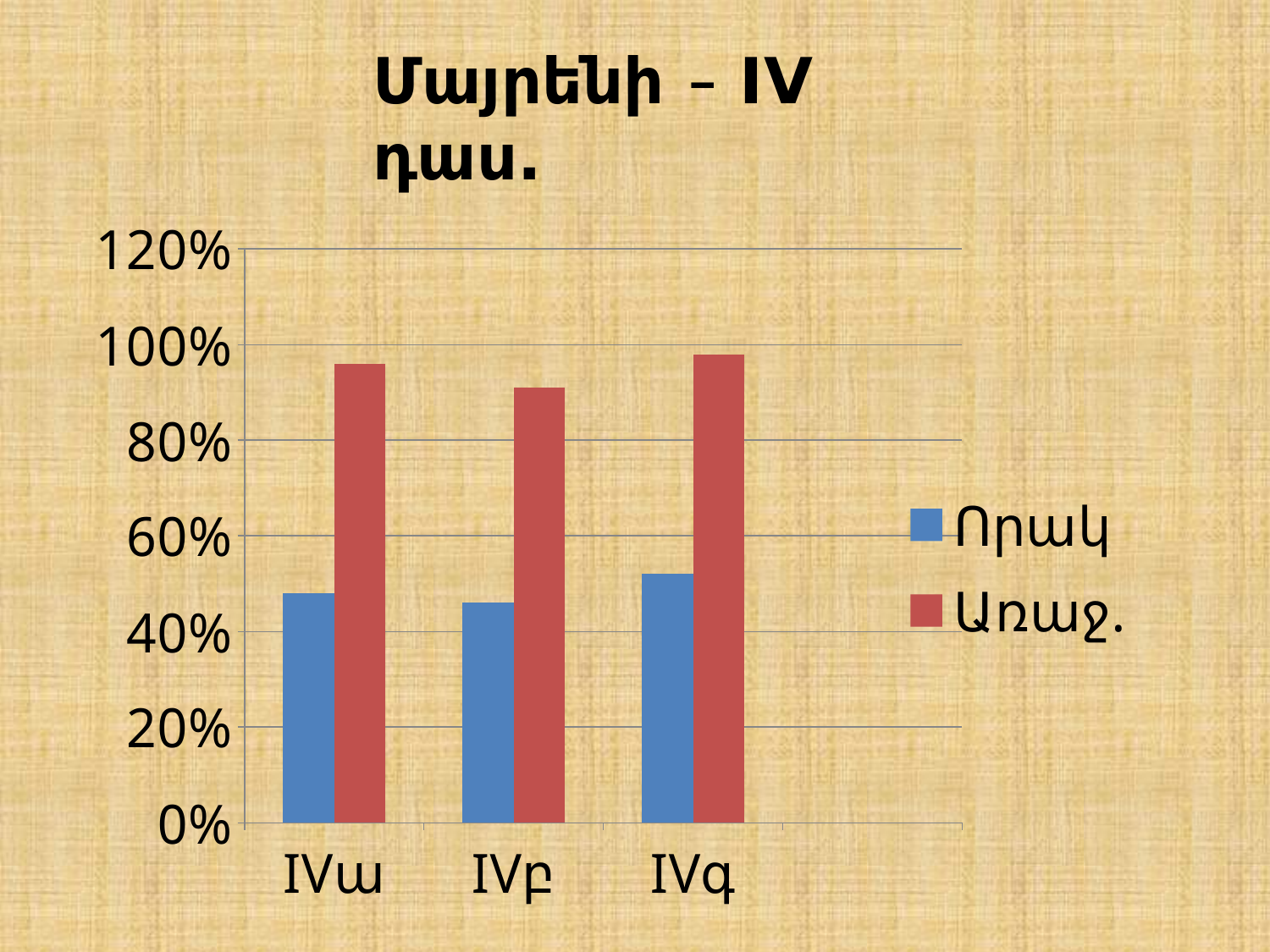
Which category has the lowest value for Առաջ.? IVբ What kind of chart is shown on the slide? bar chart Which category has the highest value for Որակ? IVգ Is the value of Առաջ. for IVբ greater or less than 80%? greater What is the title of the chart? Մայրենի - IV դաս. How many series does the legend list? 2 Which series is shown in red in the chart? Առաջ. How many categories are shown on the x axis of the chart? 3 Is the value of Որակ for IVգ greater or less than 40%? greater For IVբ, which series has the larger value, Որակ or Առաջ.? Առաջ. Is the value of Որակ for IVա greater or less than 60%? less